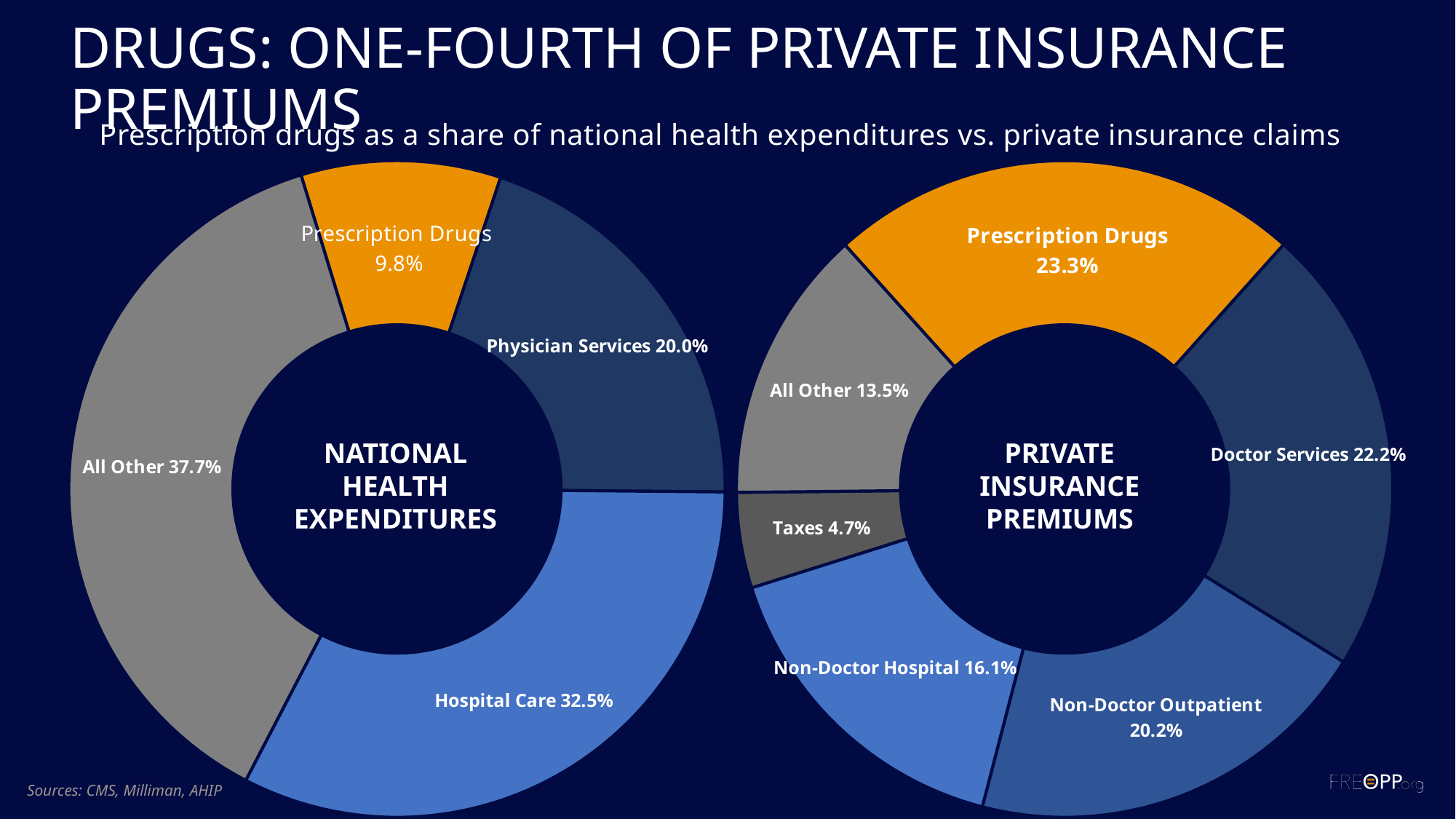
In the Private Insurance Premiums chart, which category has the largest share? Prescription Drugs What is the difference between the Prescription Drugs share in the Private Insurance Premiums chart and in the National Health Expenditures chart? 13.5 percentage points What type of chart is used on this slide? Doughnut chart In the National Health Expenditures chart, which category has the largest share? All Other In the Private Insurance Premiums chart, what share is Prescription Drugs? 23.3% In the Private Insurance Premiums chart, which is larger: Doctor Services or Non-Doctor Outpatient? Doctor Services In the National Health Expenditures chart, what share is Prescription Drugs? 9.8% In the Private Insurance Premiums chart, which category has the smallest share? Taxes In the Private Insurance Premiums chart, what share is Taxes? 4.7% How many categories are shown in the Private Insurance Premiums chart? 6 In the National Health Expenditures chart, what share is Hospital Care? 32.5% How many categories are shown in the National Health Expenditures chart? 4